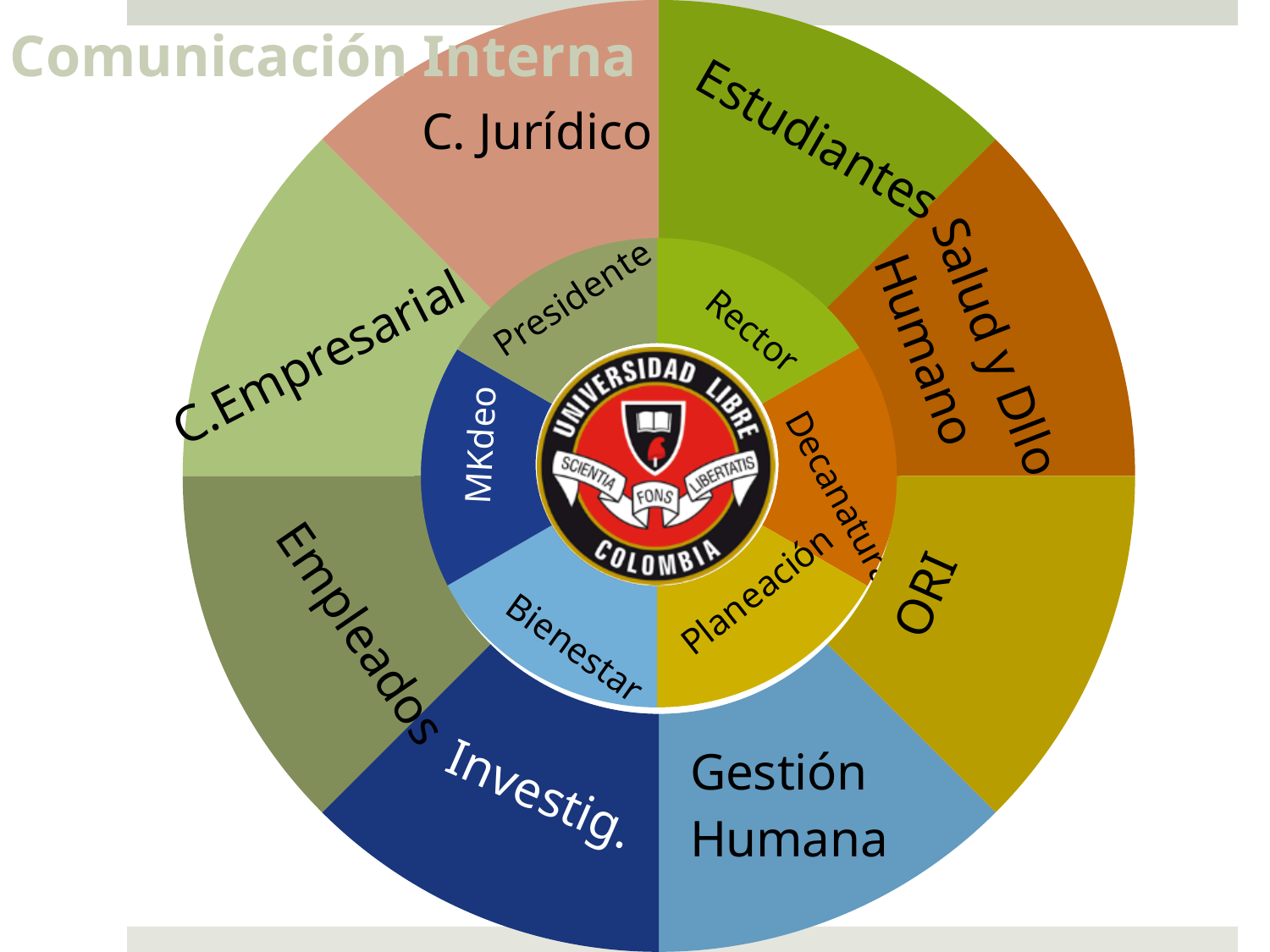
How many segments are in the outer ring of the chart? 8 Which outer-ring segment is larger, Estudiantes or Salud y Dllo Humano? Neither; they are equal in size Which outer-ring segment is larger, Estudiantes or ORI? Neither; they are equal in size How many segments are in the inner ring of the chart? 6 What colour is the Investig. segment in the outer ring? Dark blue What is the title of the chart? Comunicación Interna What kind of chart is shown on the slide? Doughnut chart